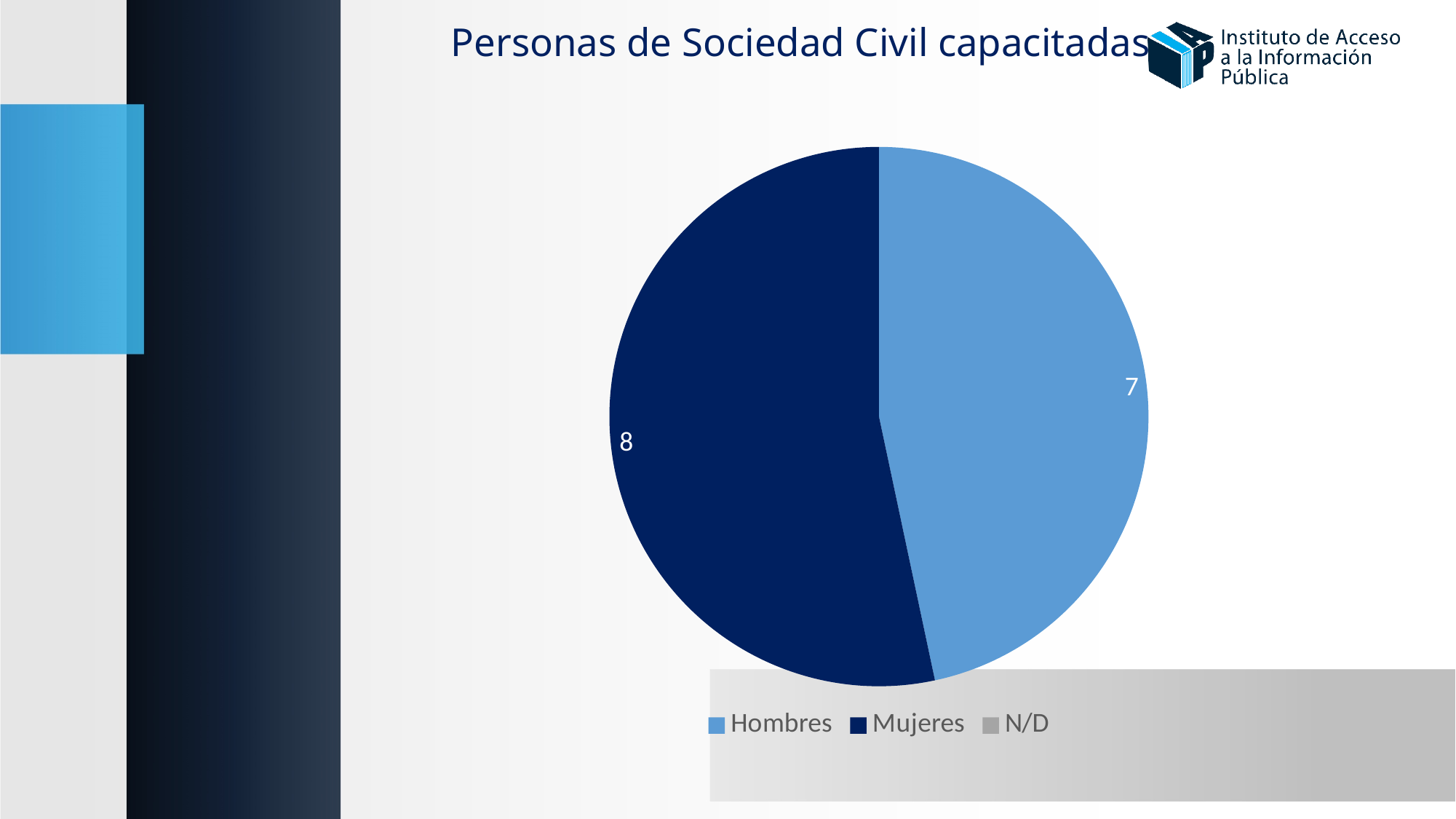
What is the value for Mujeres in the pie chart? 8 Which legend entry is shown in dark navy blue? Mujeres Is the value for Mujeres larger or smaller than the value for Hombres? larger What is the title of the chart? Personas de Sociedad Civil capacitadas What is the value for Hombres in the pie chart? 7 How many entries does the legend list? 3 Which category has the largest slice in the pie chart? Mujeres What is the difference between the values for Mujeres and Hombres? 1 How many slices with data labels are visible in the pie chart? 2 Which of the two labelled slices, Hombres or Mujeres, is smaller? Hombres What kind of chart is shown on the slide? pie chart